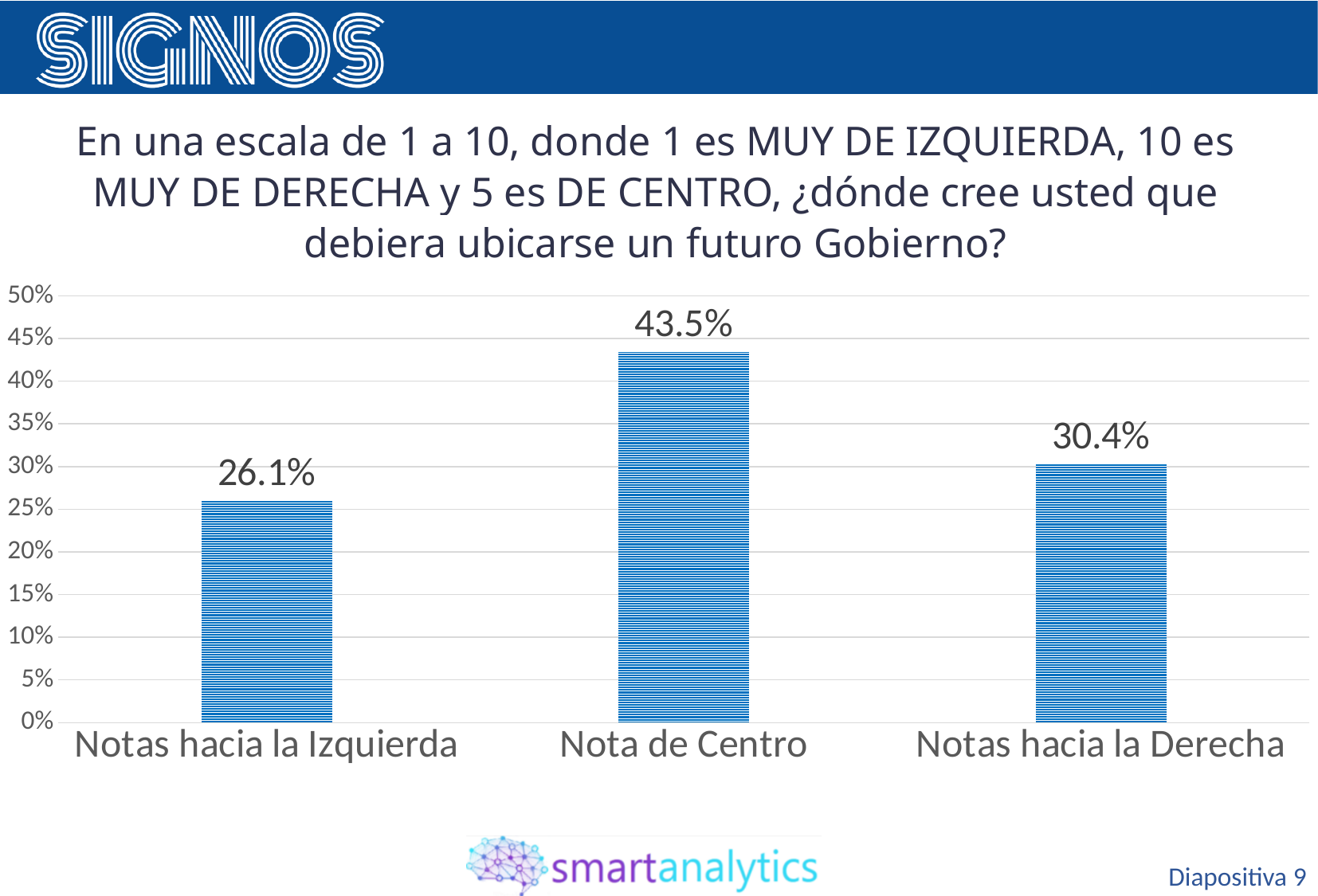
Which category has the highest value? Nota de Centro Is the value for Nota de Centro greater or less than 40%? greater What is the value for Nota de Centro? 43.5% Which category has the lowest value? Notas hacia la Izquierda What is the highest value shown on the vertical axis? 50% How many categories are shown in the chart? 3 What kind of chart is shown on the slide? bar chart What is the difference between the values for Notas hacia la Derecha and Notas hacia la Izquierda? 4.3% Which is larger, the value for Notas hacia la Derecha or the value for Notas hacia la Izquierda? Notas hacia la Derecha What is the value for Notas hacia la Izquierda? 26.1% What is the difference between the values for Nota de Centro and Notas hacia la Derecha? 13.1% What is the value for Notas hacia la Derecha? 30.4%